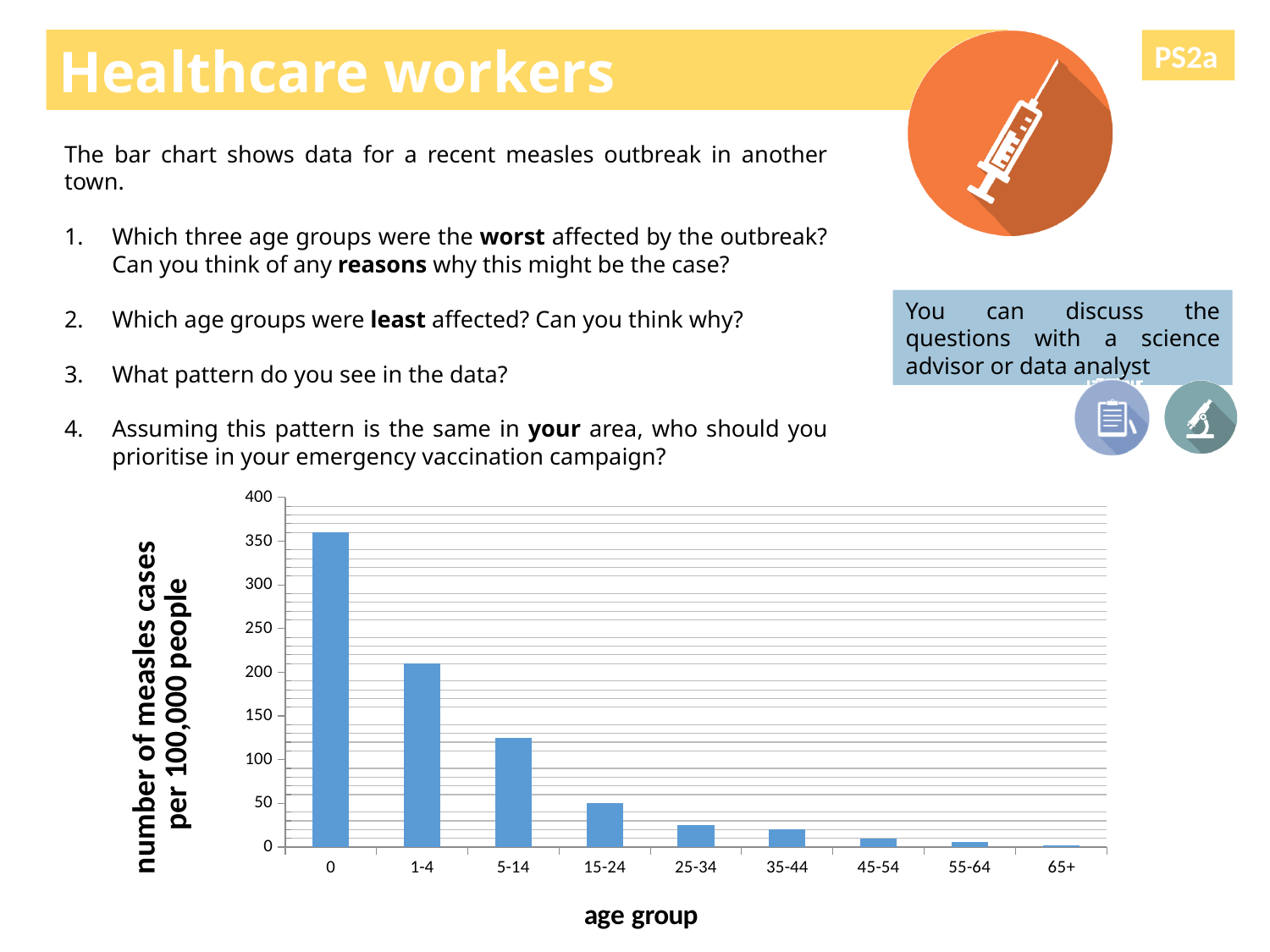
Which age group has more measles cases per 100,000 people, 1-4 or 5-14? 1-4 Is the value for the 5-14 age group greater or less than 150? less Which age group has the lowest number of measles cases per 100,000 people? 65+ Is the value for the 0 age group greater or less than 350? greater What is the label on the y axis of the chart? number of measles cases per 100,000 people What kind of chart is shown on the slide? bar chart Do the values rise or fall as age group increases along the x axis? fall Is the value for the 25-34 age group greater or less than 50? less Which age group has the highest number of measles cases per 100,000 people? 0 How many age groups are shown on the x axis of the chart? 9 What is the label on the x axis of the chart? age group